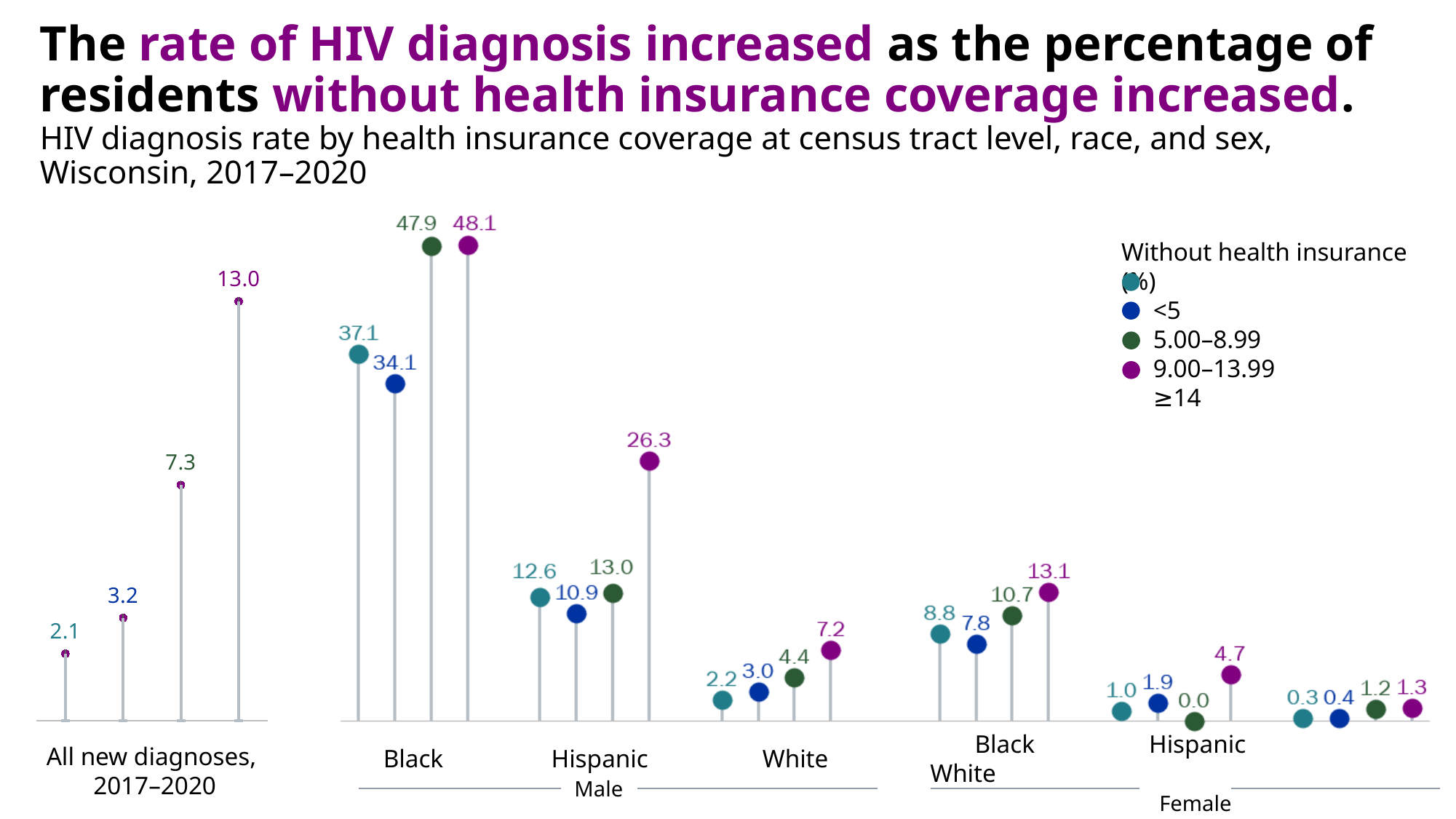
Within the 'All new diagnoses, 2017–2020' group, do the values rise or fall from left to right? rise Which is larger: the purple marker for Hispanic males (26.3) or the purple marker for Black females (13.1)? Hispanic males (26.3) What is the difference between the purple marker (48.1) and the teal marker (37.1) in the Black male group? 11.0 What is the HIV diagnosis rate for the purple marker in the Black male group? 48.1 What is the value of the green marker in the Hispanic female group? 0.0 Which race-and-sex group contains the highest HIV diagnosis rate on the chart? Black male What is the highest value shown for the 'All new diagnoses, 2017–2020' group? 13.0 How many race-and-sex groups (including 'All new diagnoses') are plotted on the chart? 7 How many health insurance coverage categories does the legend list? 4 What is the difference between the highest (13.0) and lowest (2.1) values in the 'All new diagnoses, 2017–2020' group? 10.9 What is the HIV diagnosis rate for the teal marker in the Hispanic male group? 12.6 What is the lowest value labelled anywhere on the chart? 0.0